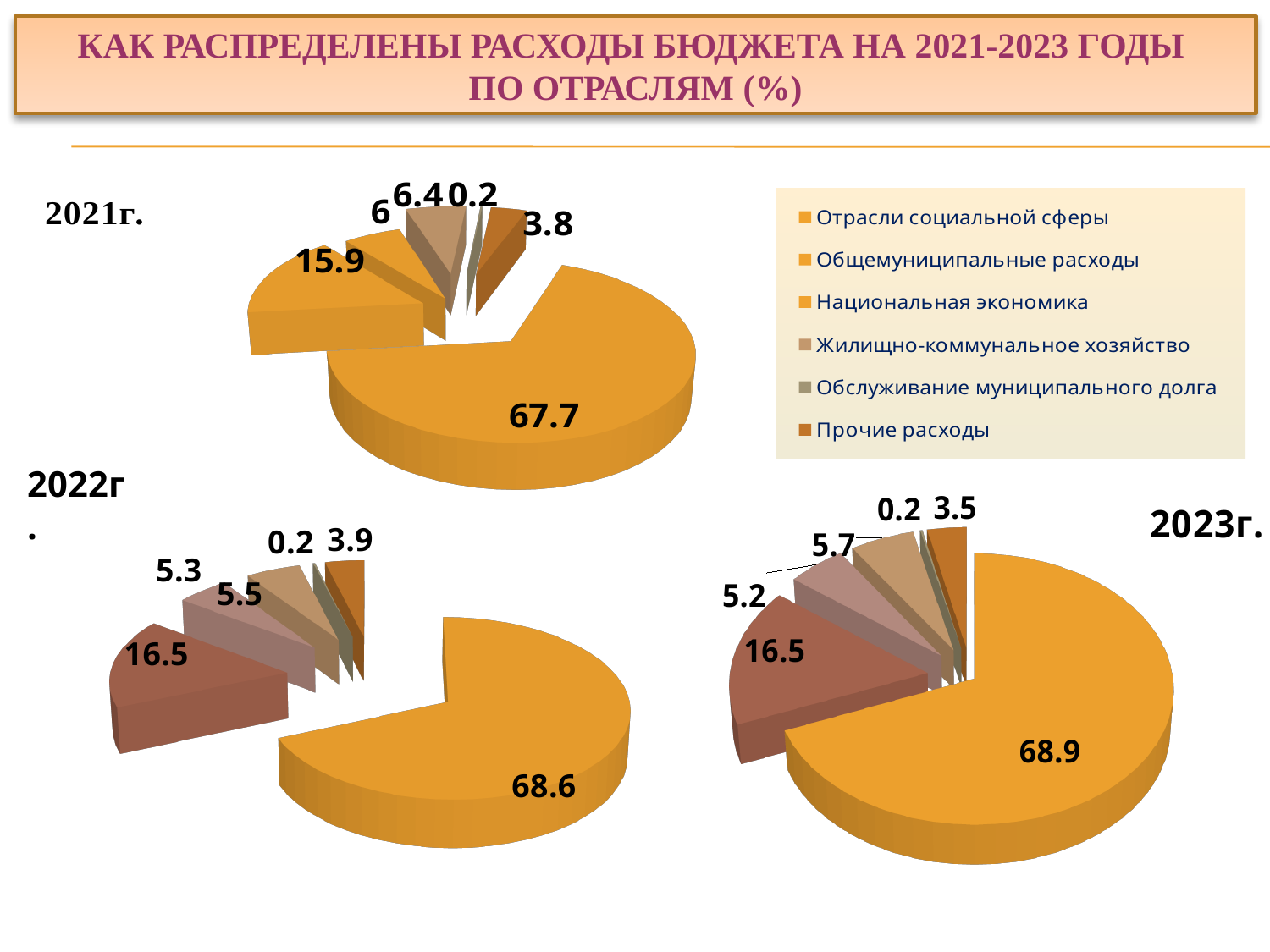
In the 2022 pie chart, what is the value of the second-largest slice? 16.5 In the 2021 pie chart, what is the value of the smallest slice? 0.2 Which is larger: the largest slice in the 2021 pie chart or the largest slice in the 2023 pie chart? 2023 (68.9) In the 2021 pie chart, what is the value for Жилищно-коммунальное хозяйство? 6.4 In the 2023 pie chart, what is the value of the largest slice? 68.9 In the 2021 pie chart, what is the value of the largest slice? 67.7 In the 2021 pie chart, what is the value for Общемуниципальные расходы? 15.9 How many entries does the legend list? 6 In the 2022 pie chart, what is the value of the largest slice? 68.6 What kind of charts are shown on the slide? pie charts In the 2023 pie chart, what is the difference between the largest slice and the second-largest slice? 52.4 How many slices does the 2022 pie chart have? 6